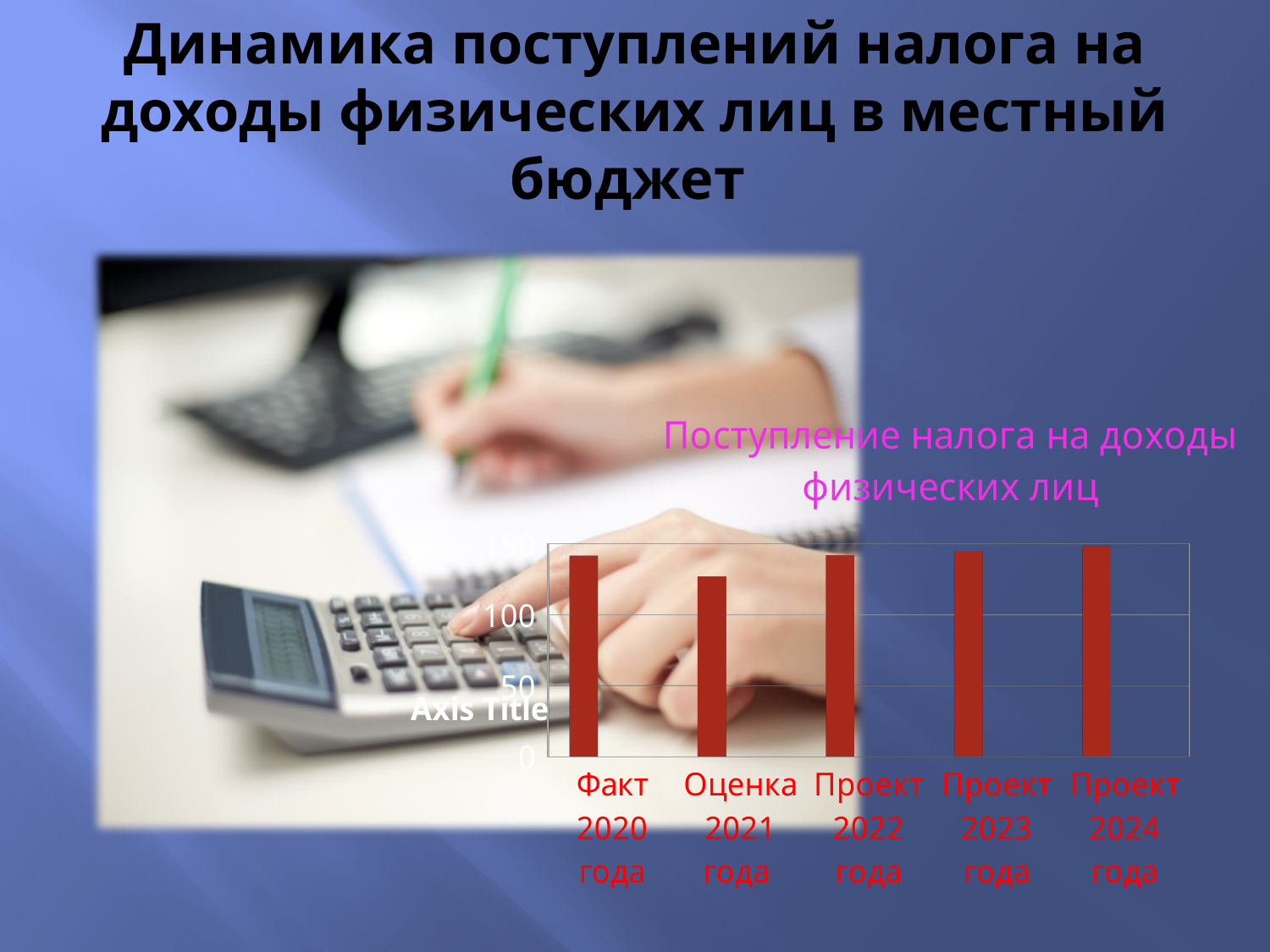
Which is larger, the value for Проект 2024 года or the value for Оценка 2021 года? Проект 2024 года What is the highest tick value shown on the vertical axis of the chart? 150 How many categories (bars) does the chart show? 5 Is the value for Оценка 2021 года greater or less than 100? greater What is the title of the chart? Поступление налога на доходы физических лиц Which is larger, the value for Факт 2020 года or the value for Оценка 2021 года? Факт 2020 года Do the values rise or fall from Оценка 2021 года to Проект 2024 года? rise Is the value for Факт 2020 года greater or less than 100? greater Is the value for Оценка 2021 года greater or less than 150? less Which category has the lowest value in the chart? Оценка 2021 года What kind of chart is shown on the slide? bar chart